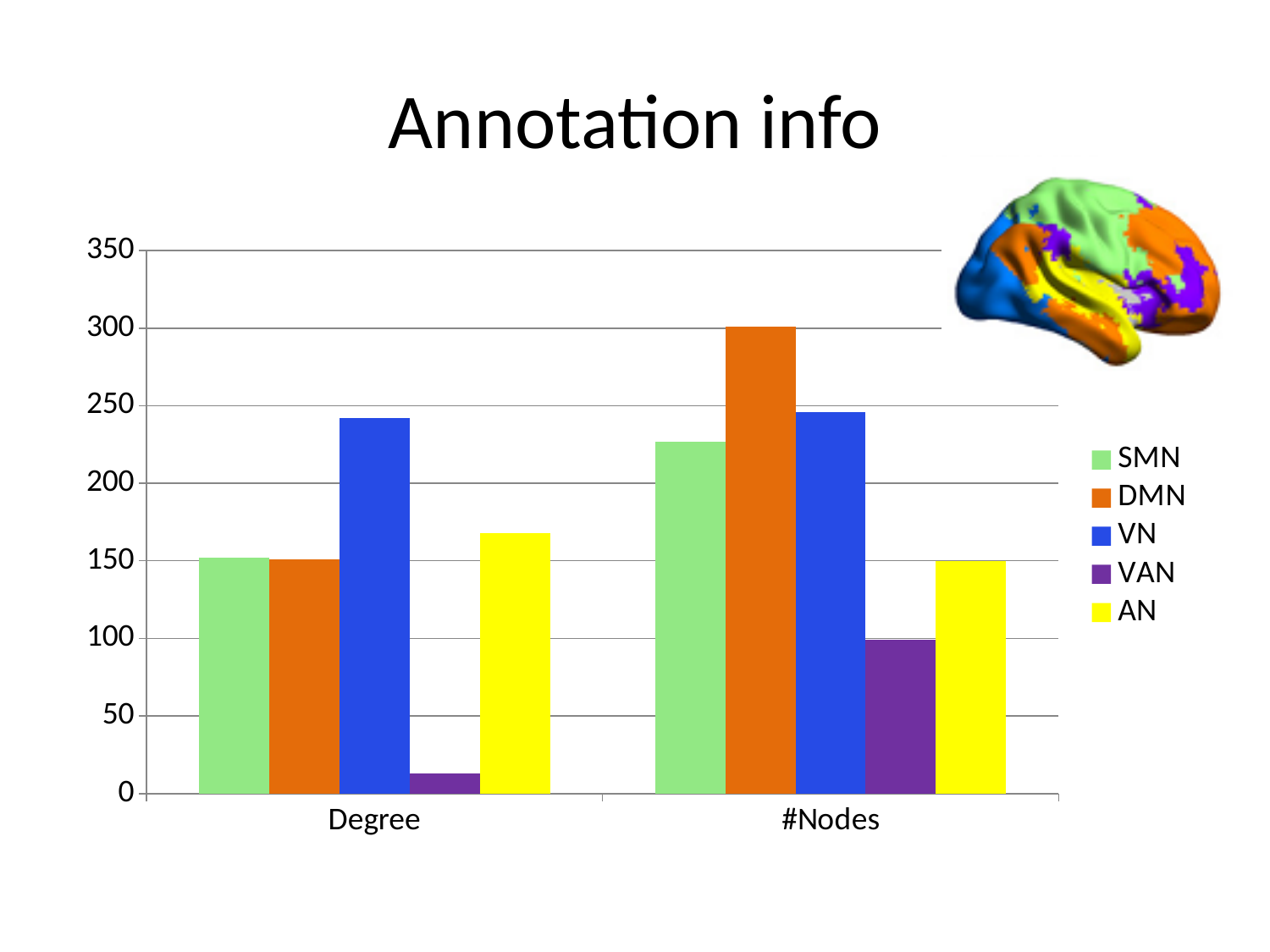
How many categories are shown on the x axis? 2 Is the #Nodes value for DMN greater or less than 250? greater What kind of chart is shown on the slide? bar chart For Degree, which is larger: VN or AN? VN Which series has the highest value for #Nodes? DMN For #Nodes, which is larger: DMN or SMN? DMN Is the Degree value for VN greater or less than 200? greater Which series has the lowest value for #Nodes? VAN How many series does the legend list? 5 Which series has the lowest value for Degree? VAN Which series has the highest value for Degree? VN Is the Degree value for VAN greater or less than 50? less